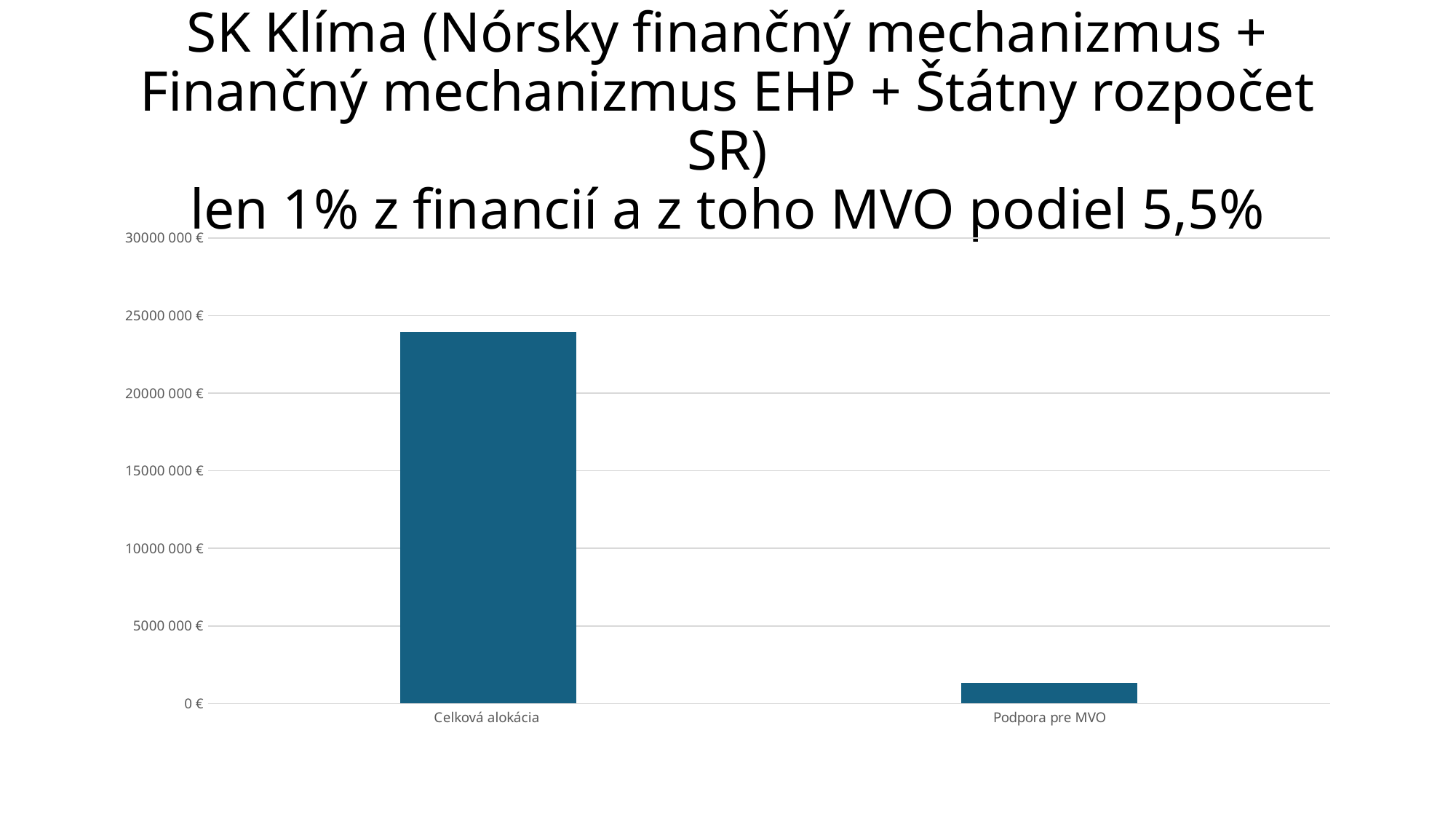
How many categories are plotted on the x axis? 2 What is the highest value shown on the y axis? 30000 000 € Is the value for Podpora pre MVO greater or less than 0 €? greater Which category has the highest value? Celková alokácia Which category has the lowest value? Podpora pre MVO Is the value for Podpora pre MVO greater or less than 5000 000 €? less Is the value for Celková alokácia greater or less than 25000 000 €? less Which is larger, the value for Celková alokácia or the value for Podpora pre MVO? Celková alokácia What kind of chart is shown on the slide? bar chart What is the label of the category on the right side of the x axis? Podpora pre MVO